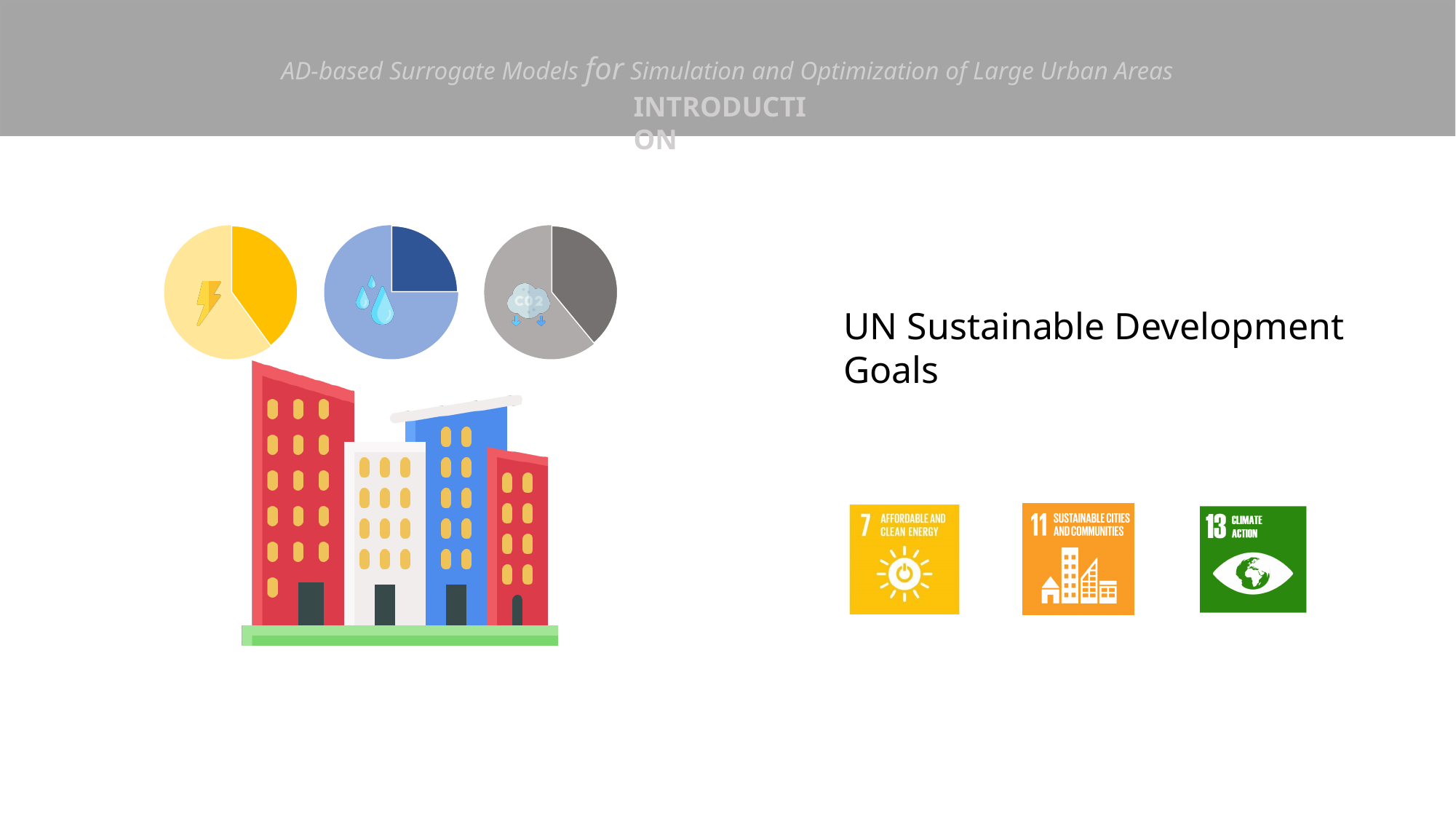
How many slices does the blue pie chart with the water-drop icon have? 2 How many slices does the yellow pie chart with the lightning-bolt icon have? 2 Which icon appears inside the leftmost pie chart? a lightning bolt In the blue pie chart with the water-drop icon, which slice is larger, the light blue slice or the dark blue slice? the light blue slice Which icon appears inside the rightmost pie chart? a CO2 cloud What kind of charts are the three circular graphics at the top left of the slide? pie charts How many pie charts are shown on the slide? 3 In the yellow pie chart with the lightning-bolt icon, which slice is larger, the light yellow slice or the dark yellow slice? the light yellow slice In the grey pie chart with the CO2 icon, which slice is larger, the light grey slice or the dark grey slice? the light grey slice